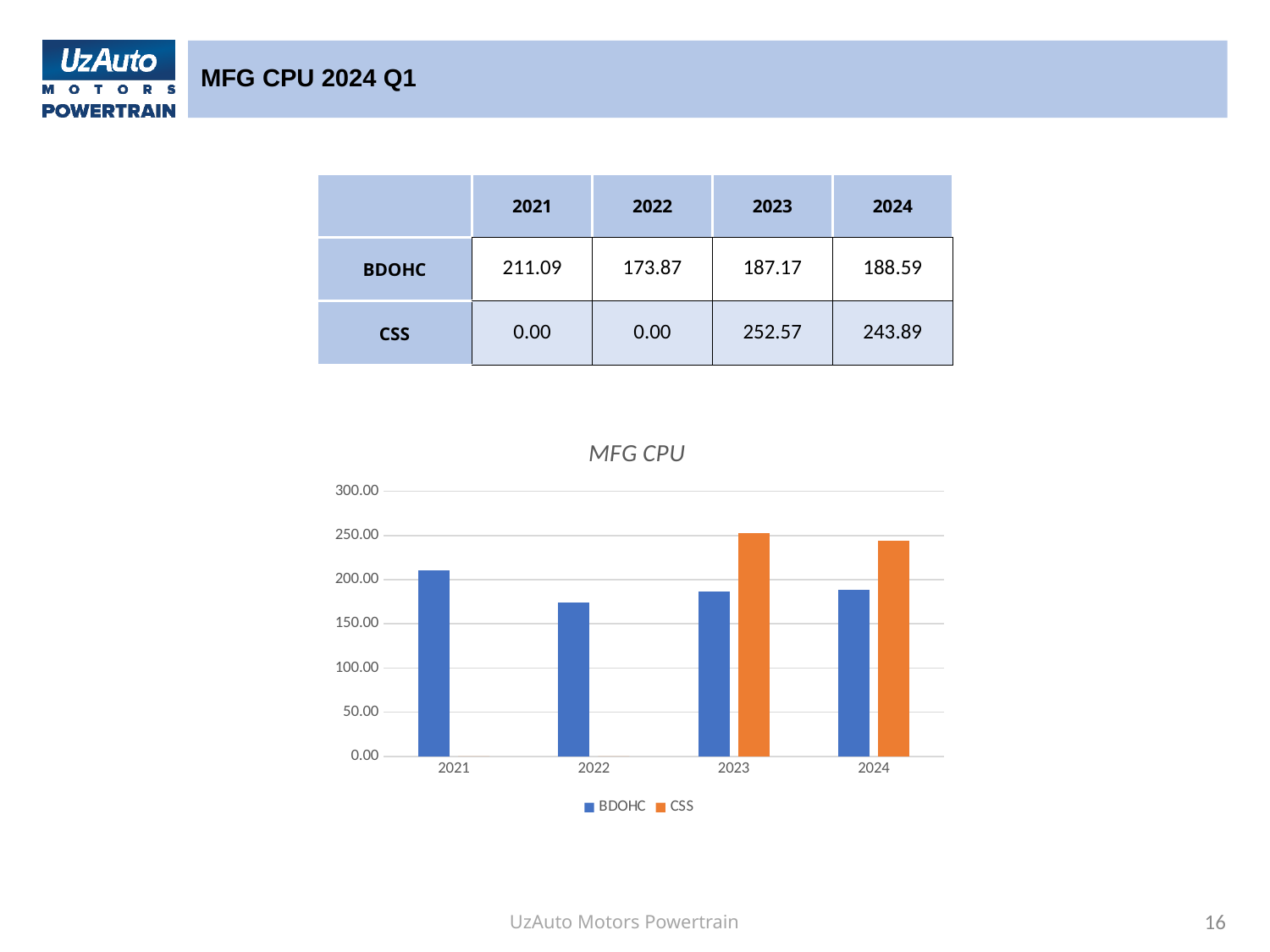
In which year is the BDOHC value highest? 2021 Which is larger in 2023, BDOHC or CSS? CSS What is the CSS value for 2023? 252.57 Is the BDOHC value for 2022 greater or less than 200.00? less How many series does the chart legend list? 2 What is the title of the chart? MFG CPU How many years are shown on the x axis of the chart? 4 What is the CSS value for 2024? 243.89 What type of chart is shown on the slide? bar chart In which year is the BDOHC value lowest? 2022 What is the BDOHC value for 2021? 211.09 What is the difference between the CSS value in 2023 and in 2024? 8.68